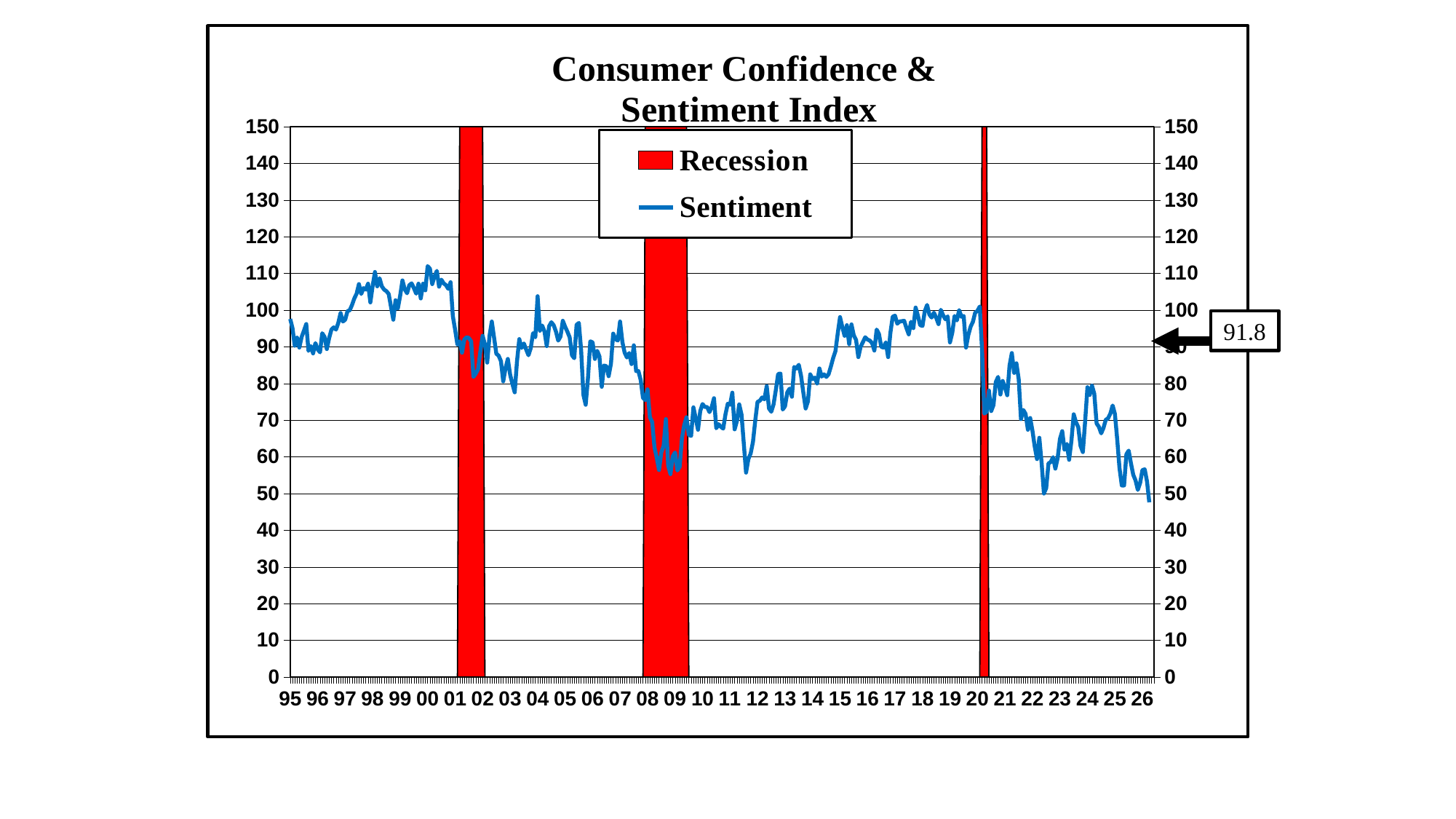
Is the Sentiment value at the far right end of the line (2026) greater or less than 60? less What value does the arrow annotation at the right edge of the chart point to? 91.8 What kind of chart is shown on the slide? line chart What is the title of the chart? Consumer Confidence & Sentiment Index Does the Sentiment line generally rise or fall from 2021 to 2026? fall Is the Sentiment value at its low point during the 2008-09 recession greater or less than 70? less Is the Sentiment value around 2000 greater or less than 100? greater How many entries does the chart legend list? 2 How many red recession bands are shaded on the chart? 3 What is the maximum value shown on the vertical axis? 150 Does the Sentiment line generally rise or fall from 2011 to 2018? rise